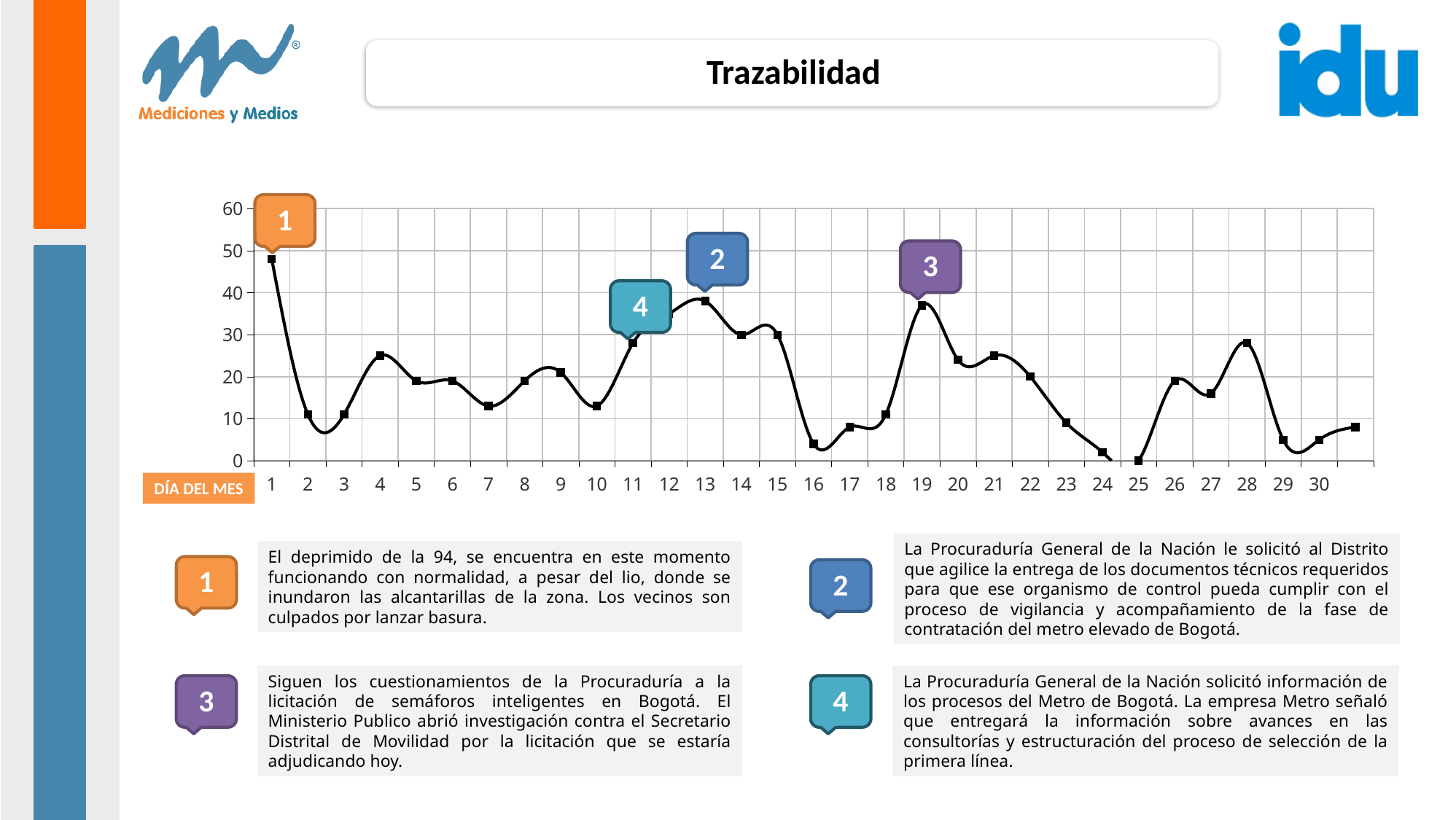
What is the value for day 25? 0 Which day has the larger value, day 13 or day 17? day 13 Is the value for day 16 greater or less than 10? less Is the value for day 1 greater or less than 40? greater On which day of the month does the line reach its highest value? 1 What is the value for day 22? 20 Is the value for day 19 greater or less than 30? greater Does the line rise or fall from day 1 to day 2? fall What label is given to the x axis of the chart? DÍA DEL MES What kind of chart is shown on the slide? line chart What is the title shown above the chart? Trazabilidad On which day of the month does the line reach its lowest value? 25